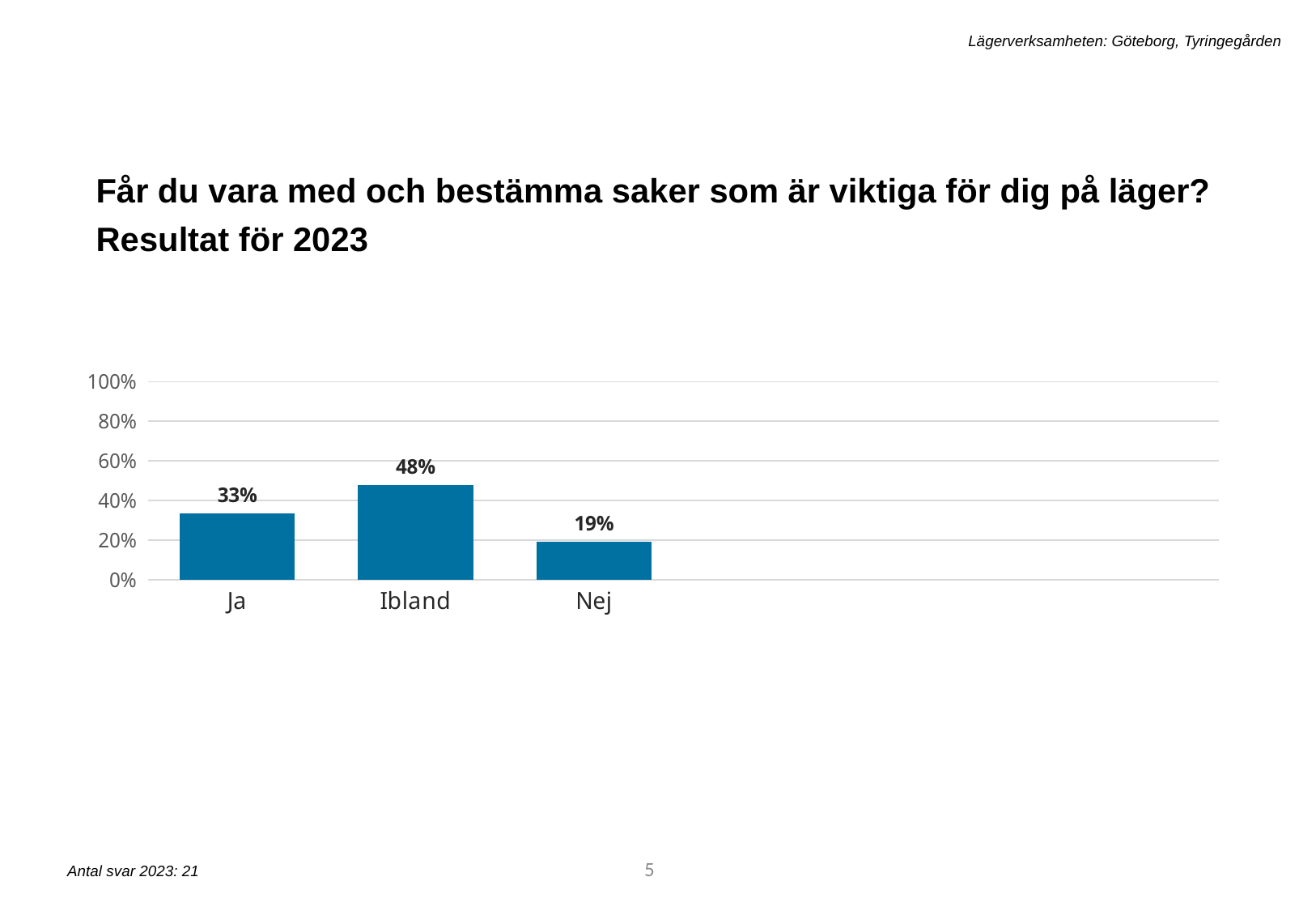
How many categories are shown on the x axis? 3 What is the difference between the values for Ja and Nej? 14% Which category has the lowest value? Nej What is the difference between the values for Ibland and Ja? 15% What is the value for Ja? 33% Which is larger, the value for Ja or the value for Nej? Ja What is the value for Nej? 19% Which category has the highest value? Ibland What kind of chart is shown on the slide? bar chart What is the value for Ibland? 48% Is the value for Ibland greater or less than 40%? greater What is the highest value shown on the y axis? 100%